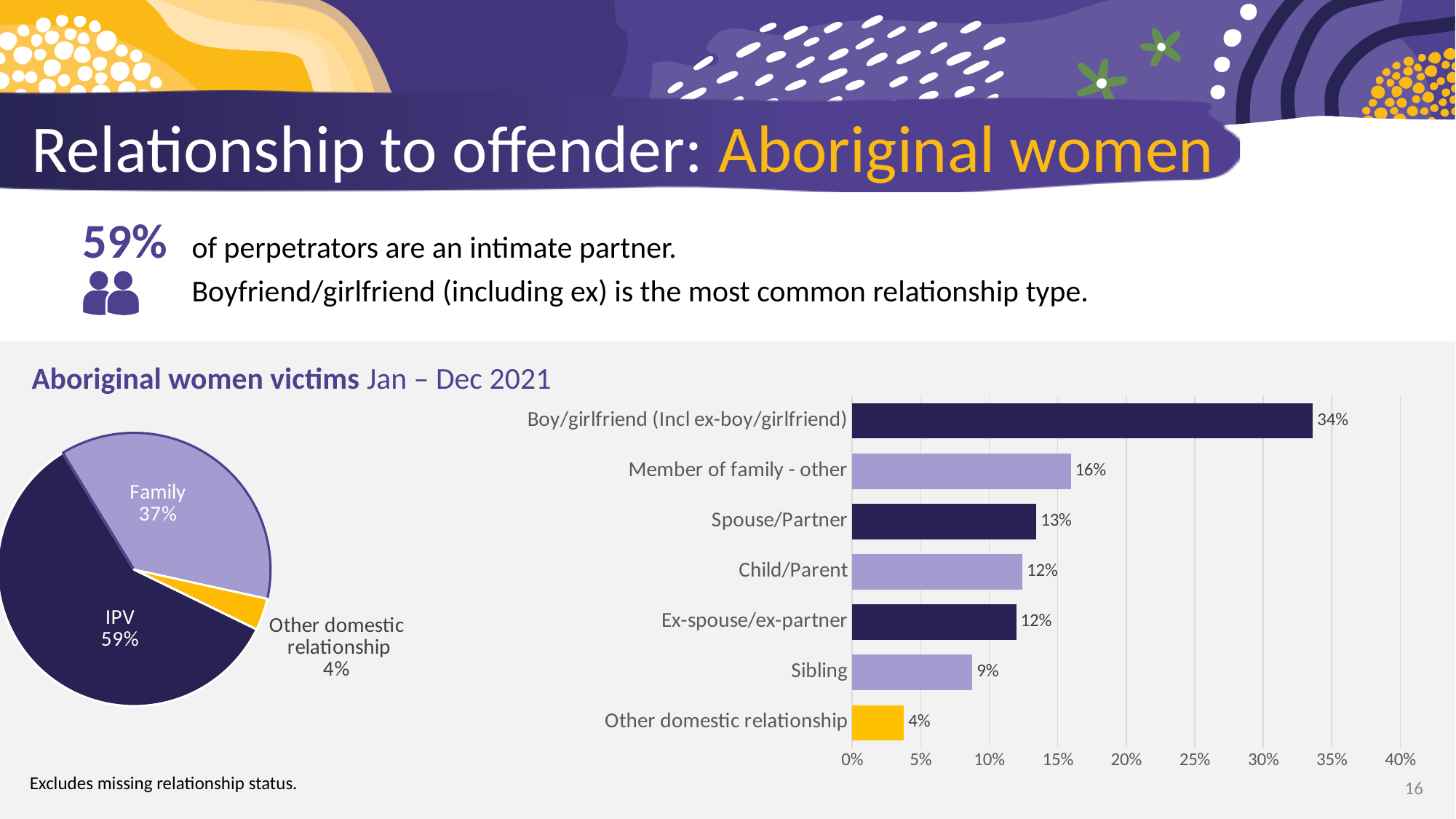
In the bar chart on the right, what is the difference between Boy/girlfriend (Incl ex-boy/girlfriend) and Spouse/Partner? 21% In the pie chart on the left, what share does IPV have? 59% What kind of chart is the chart on the right of the slide? Bar chart In the bar chart on the right, which category has the highest value? Boy/girlfriend (Incl ex-boy/girlfriend) In the bar chart on the right, what is the value for Member of family - other? 16% In the pie chart on the left, which slice is the smallest? Other domestic relationship In the bar chart on the right, which category has the lowest value? Other domestic relationship In the bar chart on the right, what is the value for Boy/girlfriend (Incl ex-boy/girlfriend)? 34% In the bar chart on the right, which is larger: Member of family - other or Sibling? Member of family - other In the pie chart on the left, what share does Family have? 37% In the bar chart on the right, what is the value for Sibling? 9% In the bar chart on the right, how many categories are shown? 7